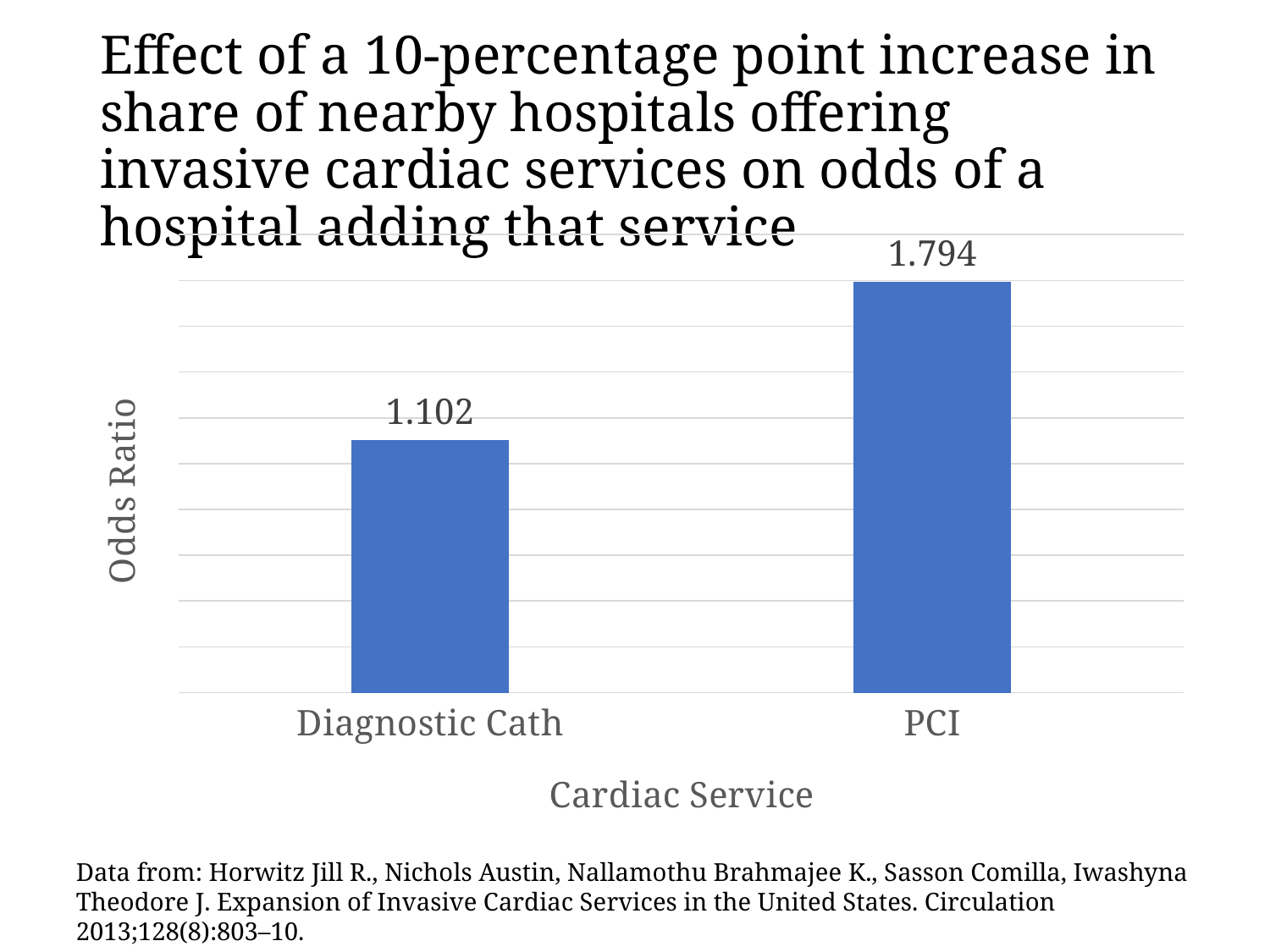
What kind of chart is shown on the slide? bar chart Which cardiac service has the lower odds ratio? Diagnostic Cath What is the label of the horizontal axis? Cardiac Service Which cardiac service has the higher odds ratio? PCI What is the label of the vertical axis? Odds Ratio What is the difference between the odds ratio for PCI and the odds ratio for Diagnostic Cath? 0.692 How many cardiac services are shown in the chart? 2 Is the odds ratio for PCI larger or smaller than the odds ratio for Diagnostic Cath? larger What is the odds ratio for PCI? 1.794 What is the odds ratio for Diagnostic Cath? 1.102